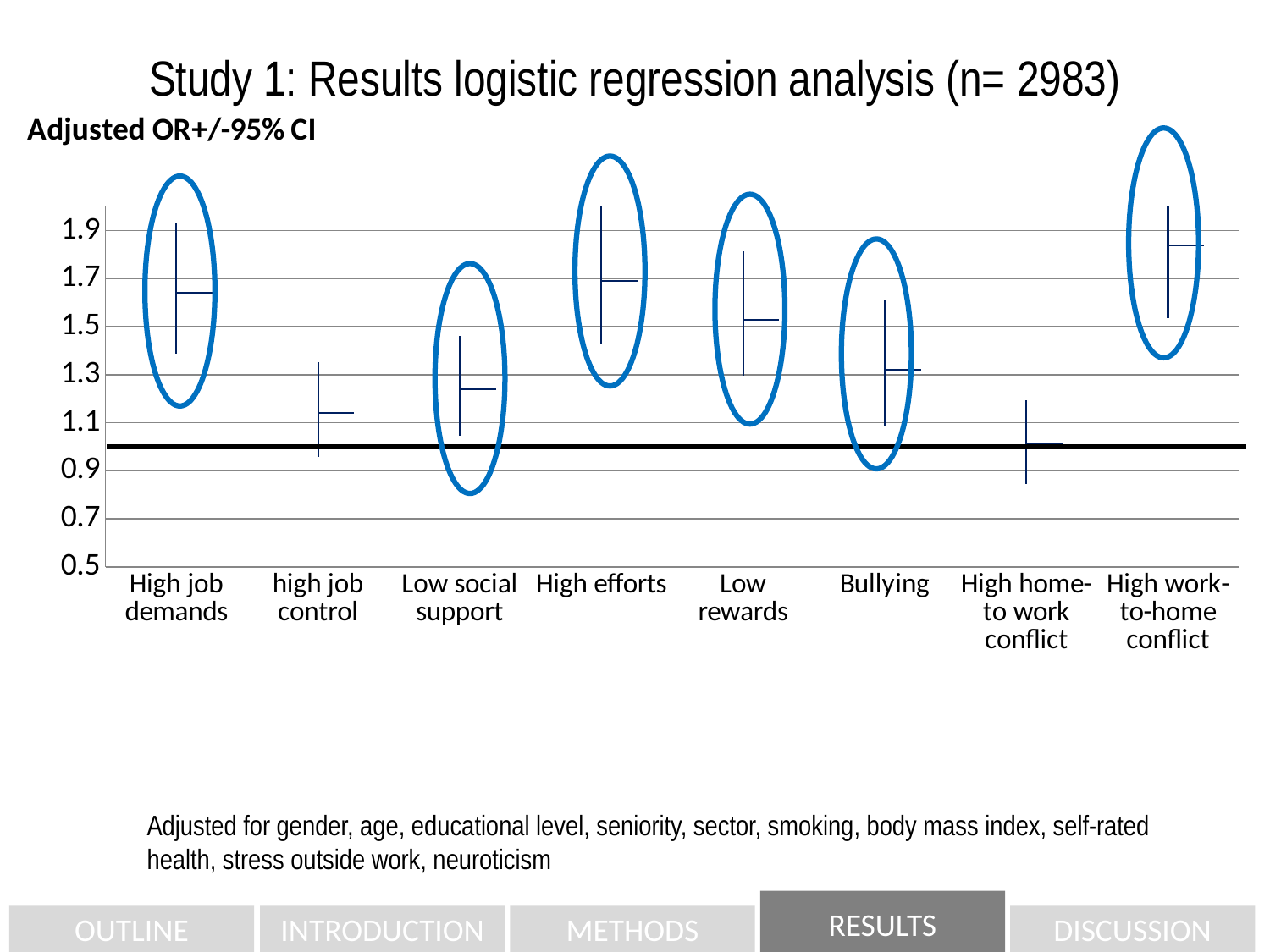
Which has the larger adjusted odds ratio, High job demands or Bullying? High job demands Is the adjusted odds ratio for High work-to-home conflict greater or less than 1.7? greater Which has the larger adjusted odds ratio, High efforts or Low rewards? High efforts Which category has the lowest adjusted odds ratio in the chart? High home-to-work conflict What is the label shown above the chart describing the plotted values? Adjusted OR+/-95% CI Is the adjusted odds ratio for Bullying greater or less than 1.5? less How many categories are shown on the x axis of the chart? 8 Which category has the highest adjusted odds ratio in the chart? High work-to-home conflict How many categories in the chart are highlighted with a blue circle? 6 Is the adjusted odds ratio for High efforts greater or less than 1.5? greater